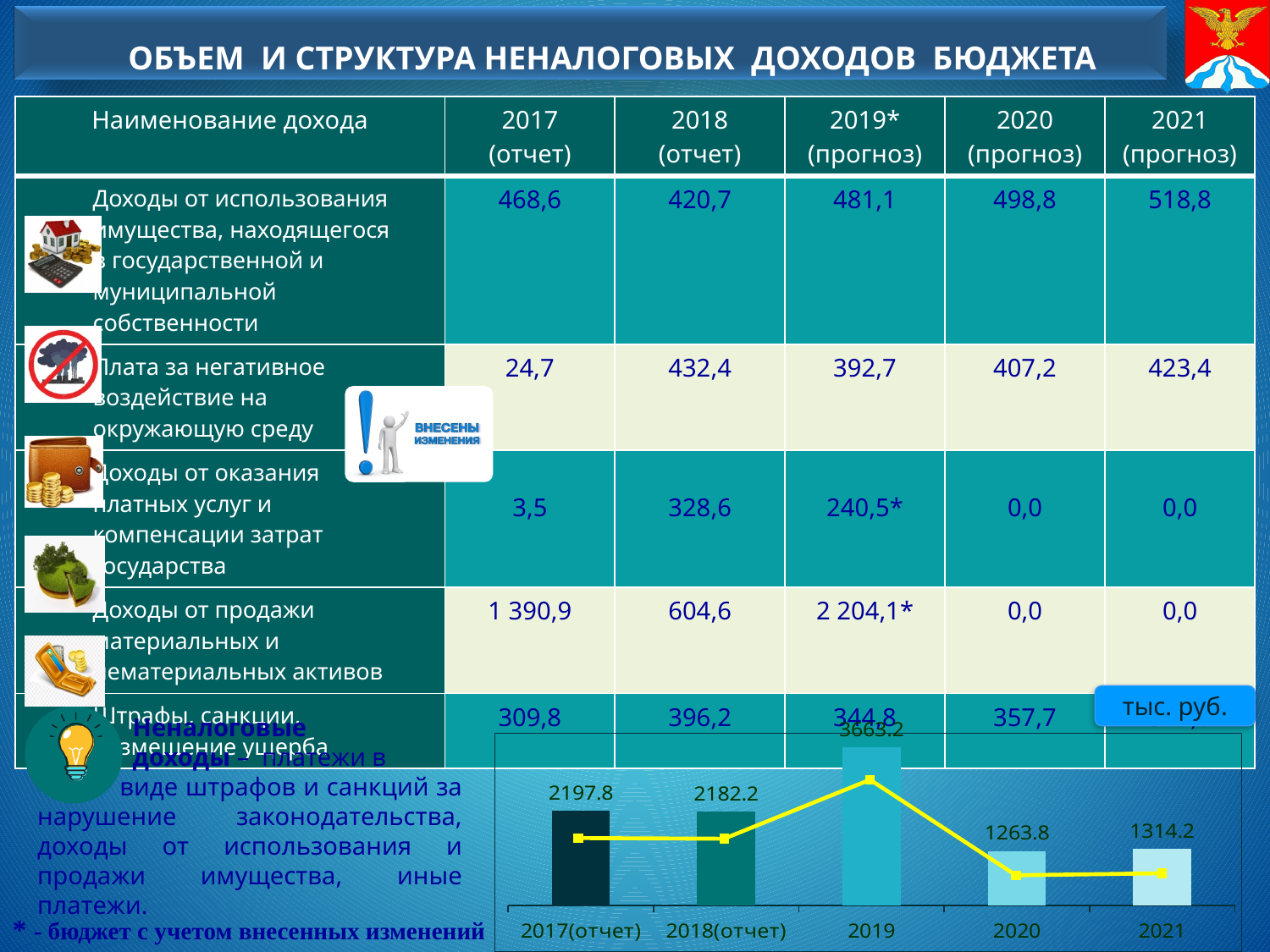
How many categories (years) are shown on the x axis of the chart at the bottom of the slide? 5 In the chart at the bottom of the slide, what is the difference between the values for 2021 and 2020? 50.4 In the chart at the bottom of the slide, do the values rise or fall from 2019 to 2020? fall In the chart at the bottom of the slide, what is the value for 2017(отчет)? 2197.8 In the chart at the bottom of the slide, which year has the lowest value? 2020 In the chart at the bottom of the slide, what is the difference between the values for 2019 and 2018(отчет)? 1481.0 In the chart at the bottom of the slide, which is larger: the value for 2020 or for 2021? 2021 What unit is indicated for the chart at the bottom of the slide? тыс. руб. In the chart at the bottom of the slide, what is the value for 2021? 1314.2 In the chart at the bottom of the slide, which is larger: the value for 2017(отчет) or for 2018(отчет)? 2017(отчет) In the chart at the bottom of the slide, what is the value for 2019? 3663.2 In the chart at the bottom of the slide, which year has the highest value? 2019